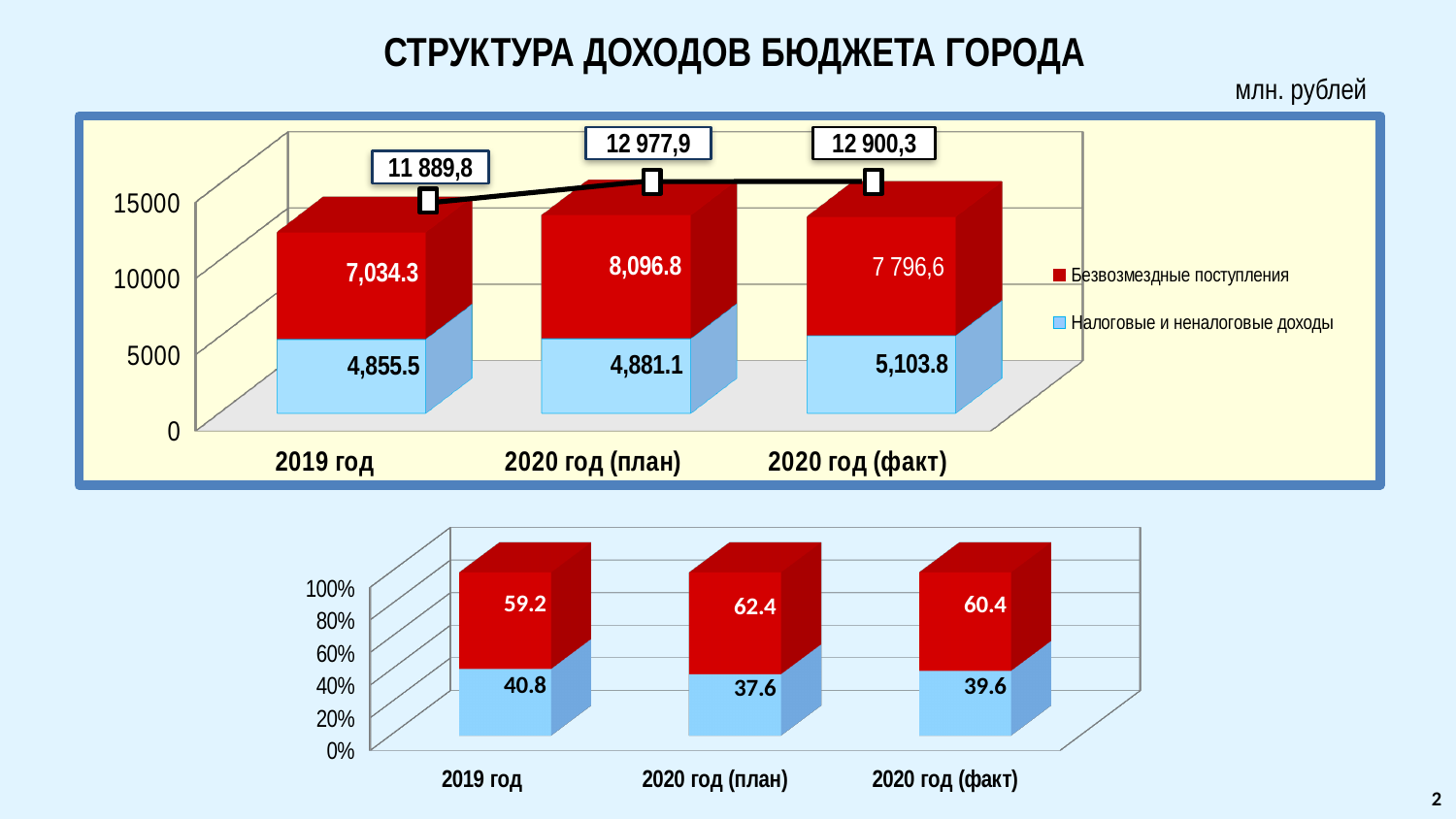
In the top chart, which is larger: Безвозмездные поступления for 2020 год (план) or for 2020 год (факт)? 2020 год (план) In the top chart, which category has the lowest value for Налоговые и неналоговые доходы? 2019 год What kind of chart is the bottom chart? Stacked bar chart In the bottom chart, what is the share of Налоговые и неналоговые доходы for 2020 год (план)? 37.6 In the top chart, what is the difference between Безвозмездные поступления for 2020 год (план) and 2019 год? 1,062.5 In the bottom chart, which category has the highest share for Безвозмездные поступления? 2020 год (план) In the top chart, what is the value of Безвозмездные поступления for 2019 год? 7,034.3 How many series does the legend of the top chart list? 2 How many categories are shown on the x axis of the bottom chart? 3 In the top chart, what total is shown above the bar for 2020 год (план)? 12 977,9 In the top chart, which category has the highest total? 2020 год (план) In the top chart, what is the value of Налоговые и неналоговые доходы for 2020 год (факт)? 5,103.8